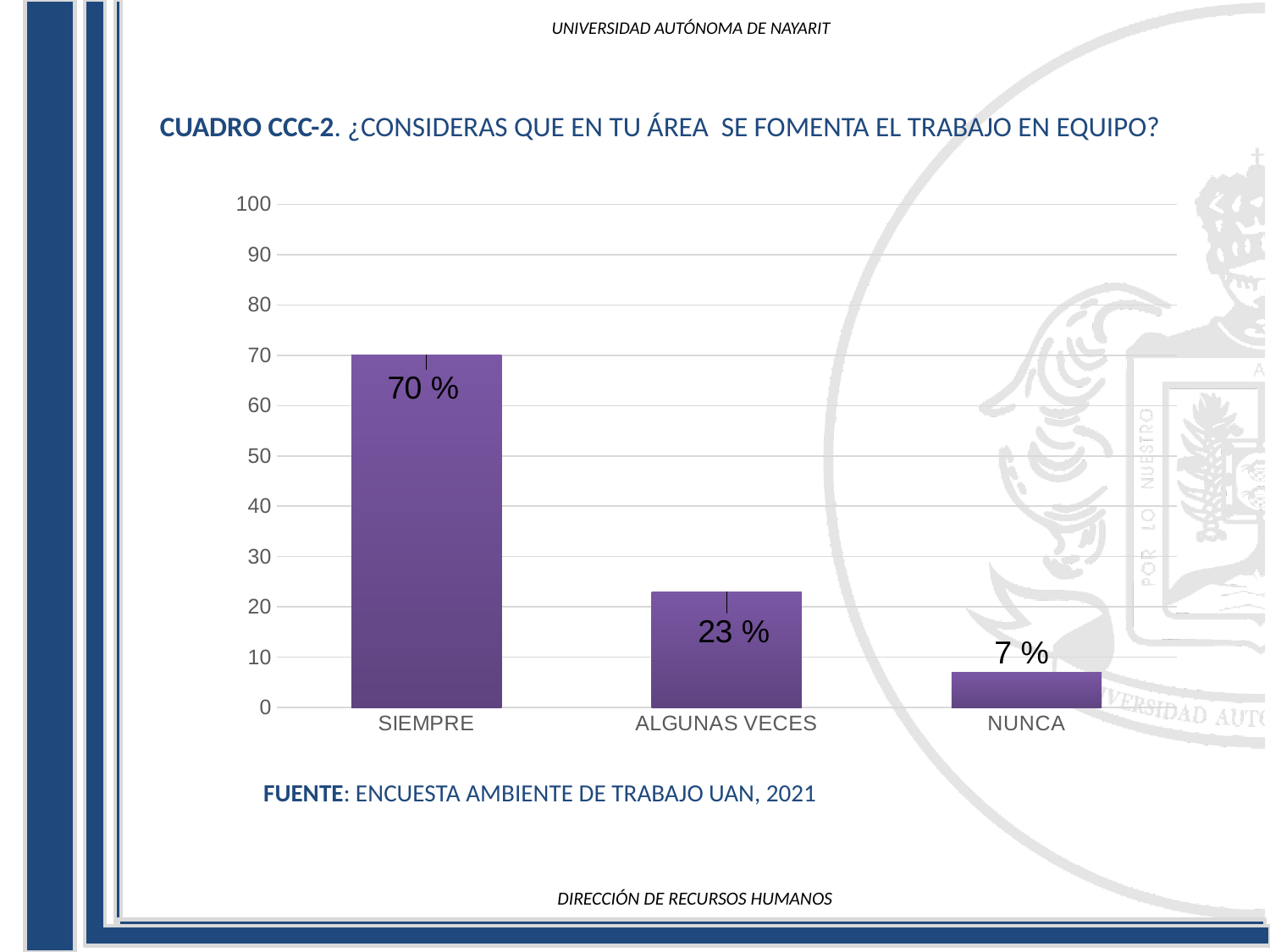
What is the value for ALGUNAS VECES? 23 % What is the difference between the values for SIEMPRE and ALGUNAS VECES? 47 % Do the values rise or fall from left to right along the x axis? fall What is the value for SIEMPRE? 70 % Which category has the highest value? SIEMPRE Which is larger, the value for ALGUNAS VECES or the value for NUNCA? ALGUNAS VECES What is the difference between the values for ALGUNAS VECES and NUNCA? 16 % What is the value for NUNCA? 7 % Is the value for SIEMPRE greater or less than 60? greater What kind of chart is shown on the slide? bar chart Which category has the lowest value? NUNCA How many categories are shown on the x axis? 3